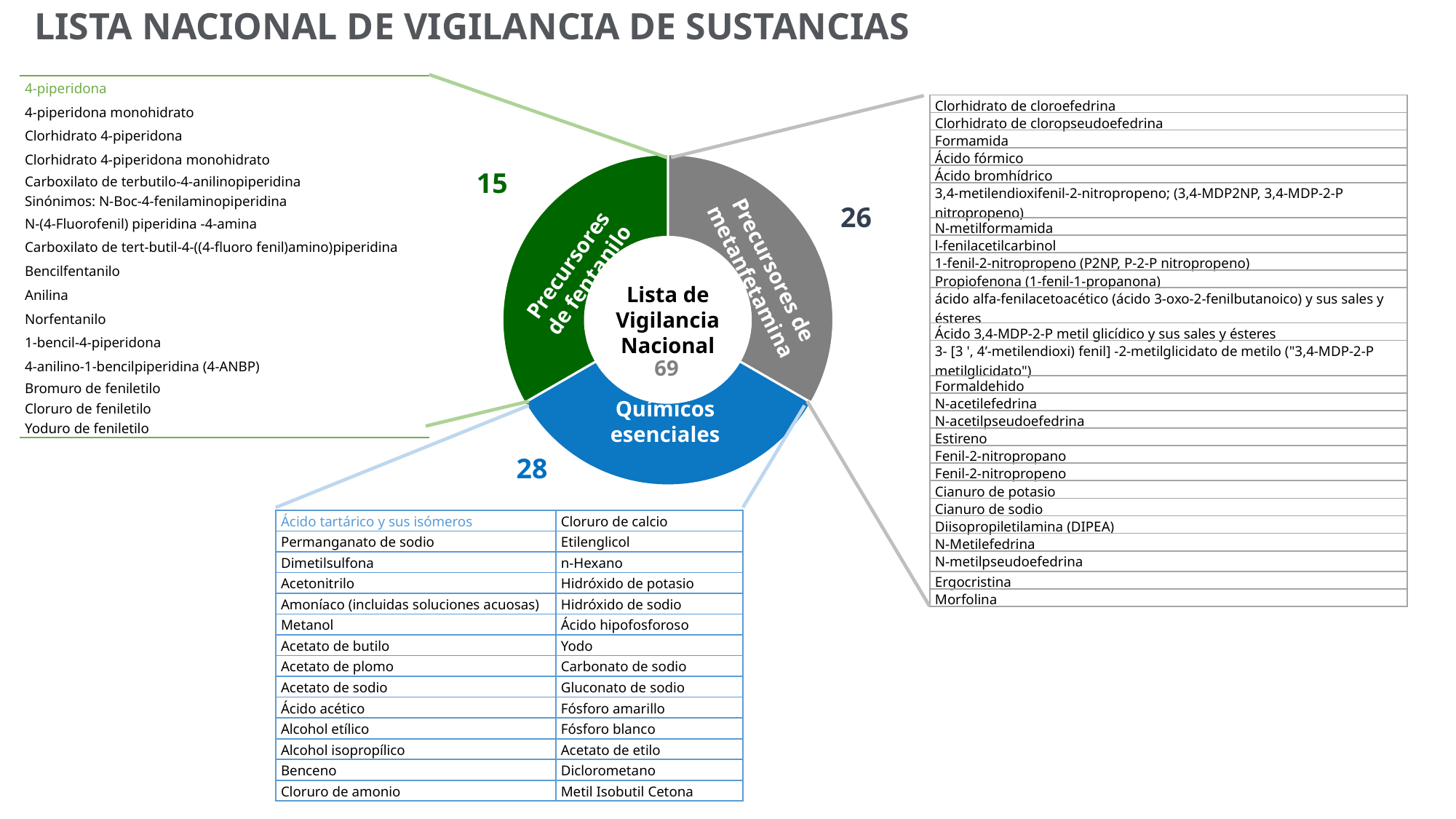
Which is larger, Precursores de metanfetamina or Precursores de fentanilo? Precursores de metanfetamina What is the difference between the Químicos esenciales value and the Precursores de fentanilo value? 13 What is the value shown for the Químicos esenciales segment? 28 What text is written in the centre of the donut chart above the total? Lista de Vigilancia Nacional What kind of chart is shown in the centre of the slide? Donut chart What is the value shown for the Precursores de fentanilo segment? 15 What is the value shown for the Precursores de metanfetamina segment? 26 Which segment of the donut chart has the lowest value? Precursores de fentanilo Which segment of the donut chart has the highest value? Químicos esenciales What colour is the Químicos esenciales segment of the donut chart? Blue How many segments does the donut chart have? 3 What total number is printed in the centre of the donut chart? 69